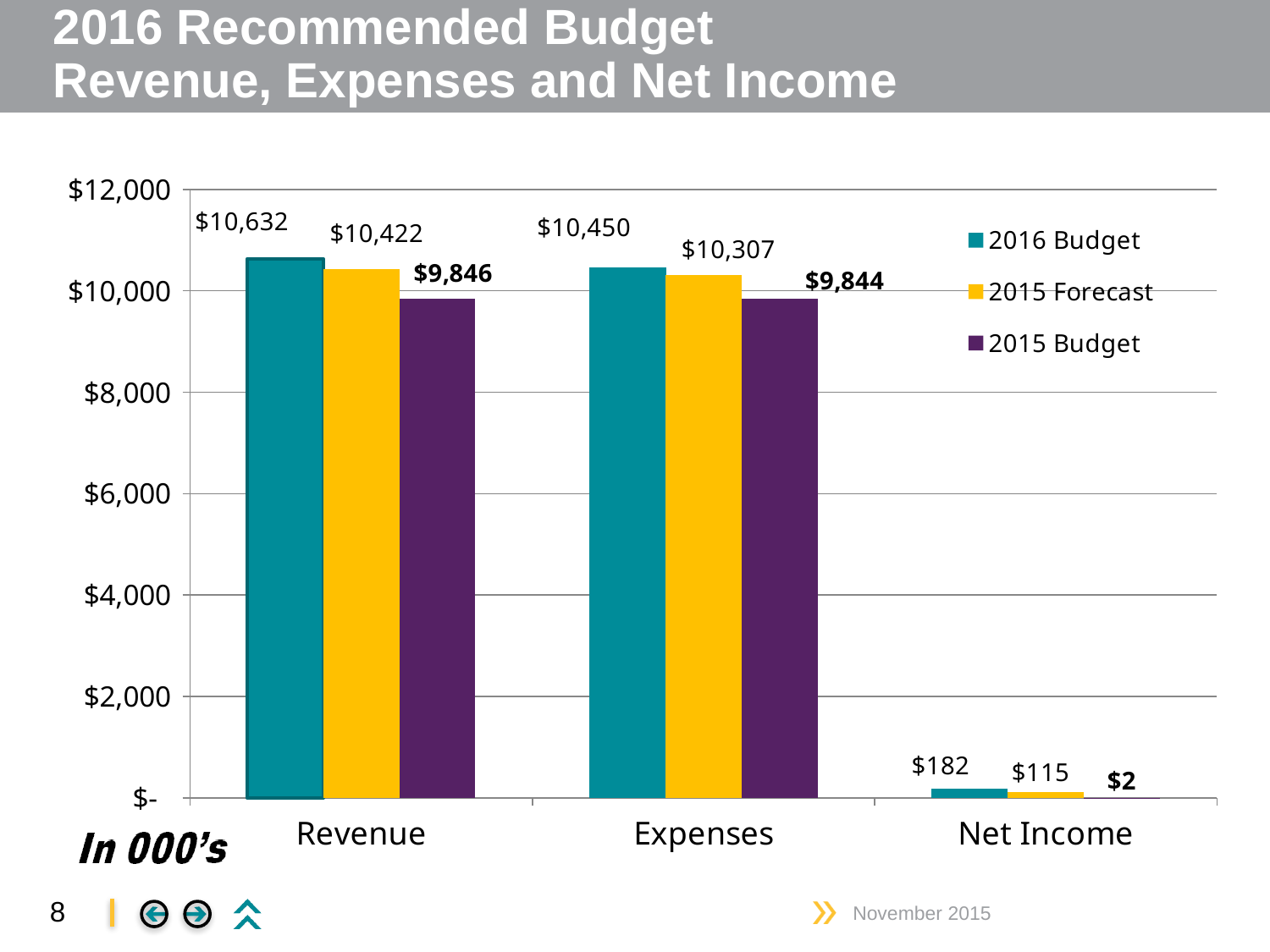
What is the 2015 Budget value for Revenue? $9,846 What is the 2015 Budget value for Net Income? $2 What is the 2015 Forecast value for Expenses? $10,307 What is the 2016 Budget value for Revenue? $10,632 What kind of chart is shown on the slide? Bar chart Which is larger: the 2015 Forecast value for Revenue or the 2015 Forecast value for Expenses? 2015 Forecast value for Revenue Which series has the highest value for Expenses? 2016 Budget What is the difference between the 2016 Budget and 2015 Forecast values for Net Income? $67 How many categories are shown on the x axis? 3 How many series does the legend list? 3 Which category has the lowest 2016 Budget value? Net Income What is the difference between the 2016 Budget and 2015 Forecast values for Revenue? $210